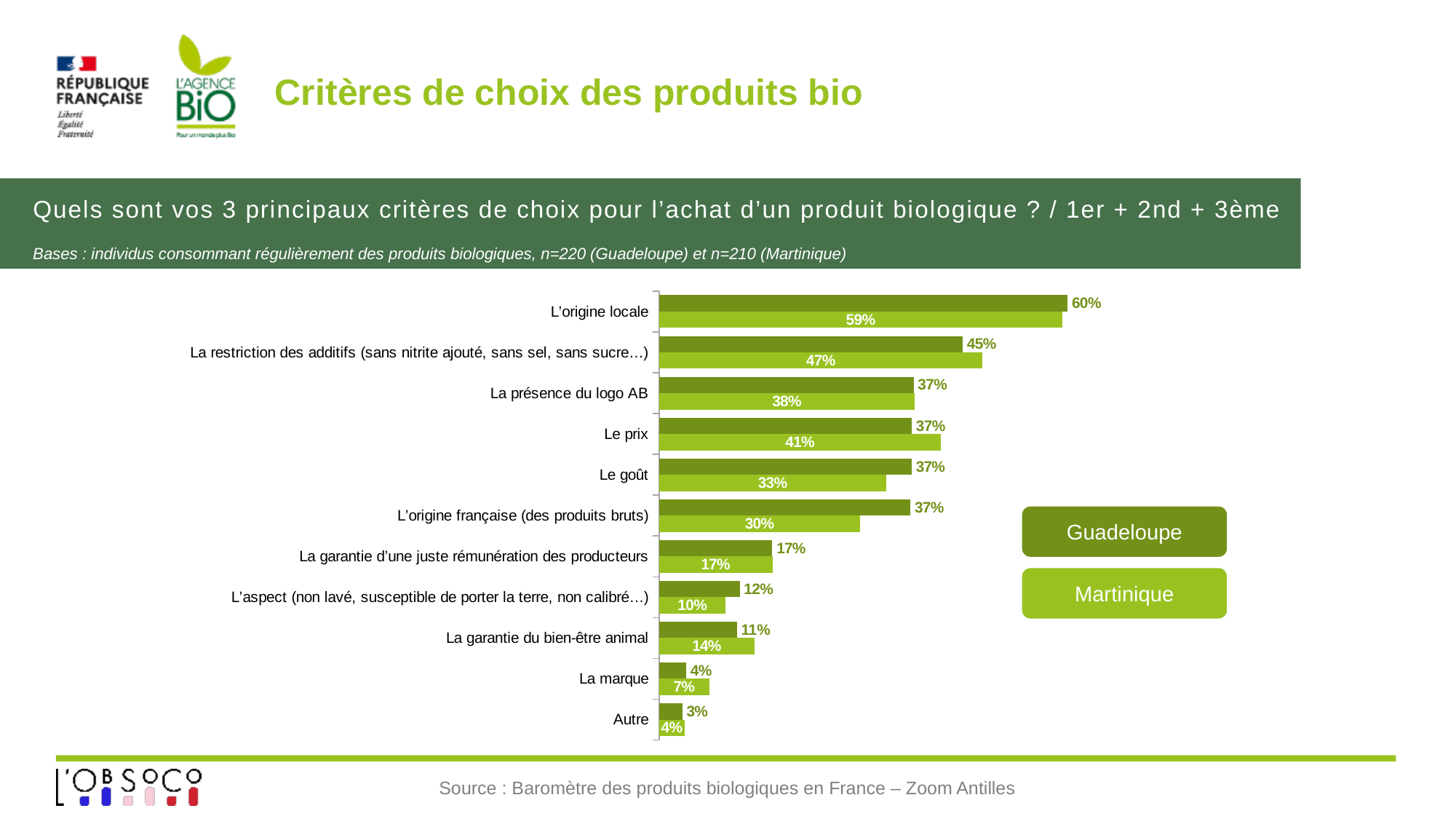
Which series is shown in the darker green colour? Guadeloupe For "Le goût", which is larger: the Guadeloupe value or the Martinique value? Guadeloupe Which criterion has the highest value for Martinique? L'origine locale What is the value for Martinique for "Le prix"? 41% What is the difference between the Guadeloupe and Martinique values for "L'origine française (des produits bruts)"? 7 percentage points What is the value for Martinique for "La garantie du bien-être animal"? 14% What kind of chart is shown on the slide? Bar chart How many criteria (categories) are shown in the chart? 11 How many series does the legend list? 2 For "La marque", which is larger: the Guadeloupe value or the Martinique value? Martinique What is the value for Guadeloupe for "L'origine locale"? 60% Which criterion has the lowest value for Guadeloupe? Autre